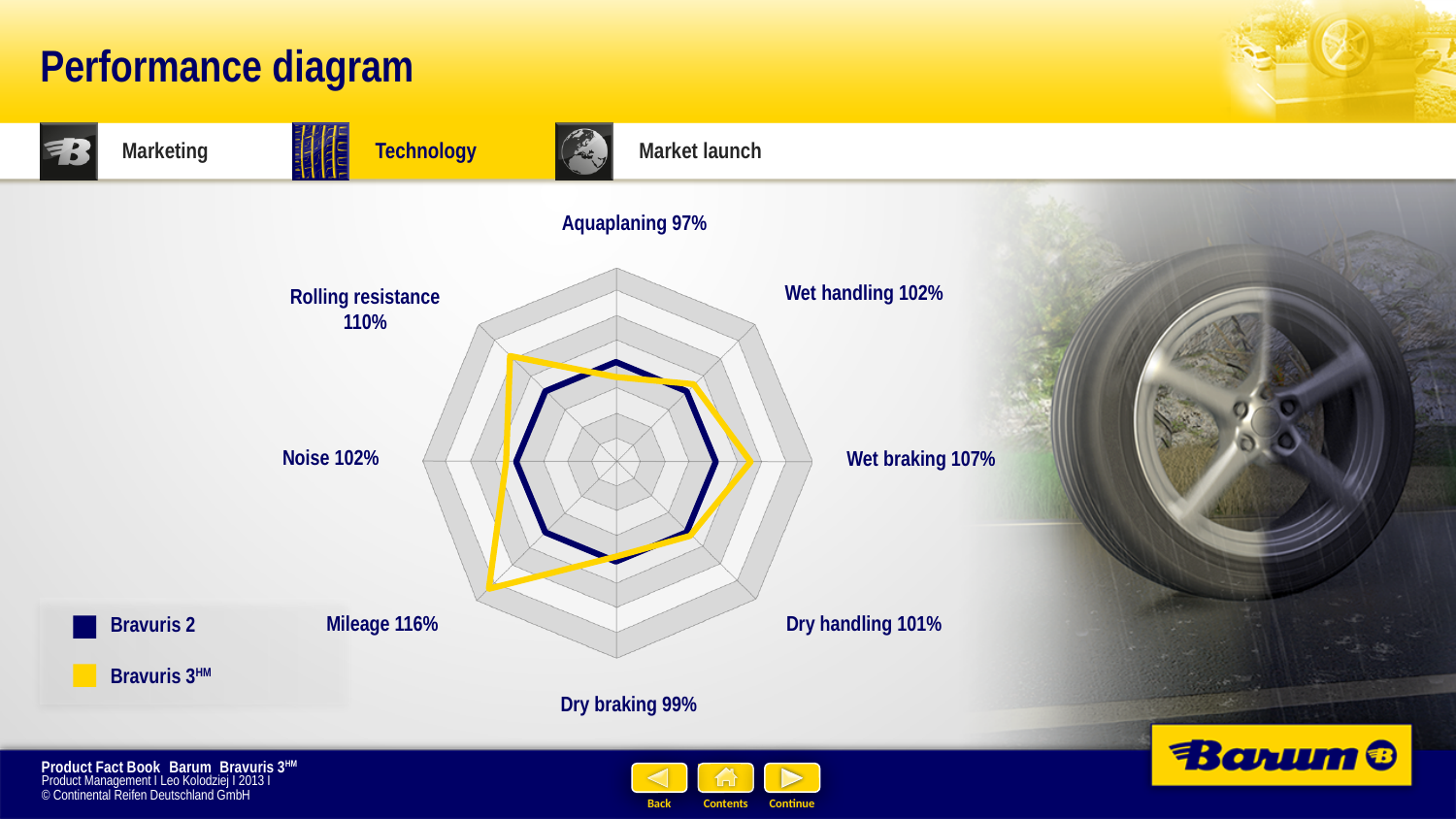
Which series is drawn in yellow on the performance diagram? Bravuris 3HM Which axis of the performance diagram shows the highest percentage? Mileage What is the difference in percentage points between the Mileage value and the Aquaplaning value on the performance diagram? 19 What percentage is shown for Aquaplaning on the performance diagram? 97% What percentage is shown next to the Mileage axis on the performance diagram? 116% How many performance criteria (axes) does the performance diagram have? 8 What percentage is shown for Rolling resistance on the performance diagram? 110% Which shows a higher percentage on the performance diagram, Wet braking or Wet handling? Wet braking How many series does the legend of the performance diagram list? 2 Which axis of the performance diagram shows the lowest percentage? Aquaplaning What type of chart is the performance diagram? Radar chart What percentage is shown for Wet braking on the performance diagram? 107%